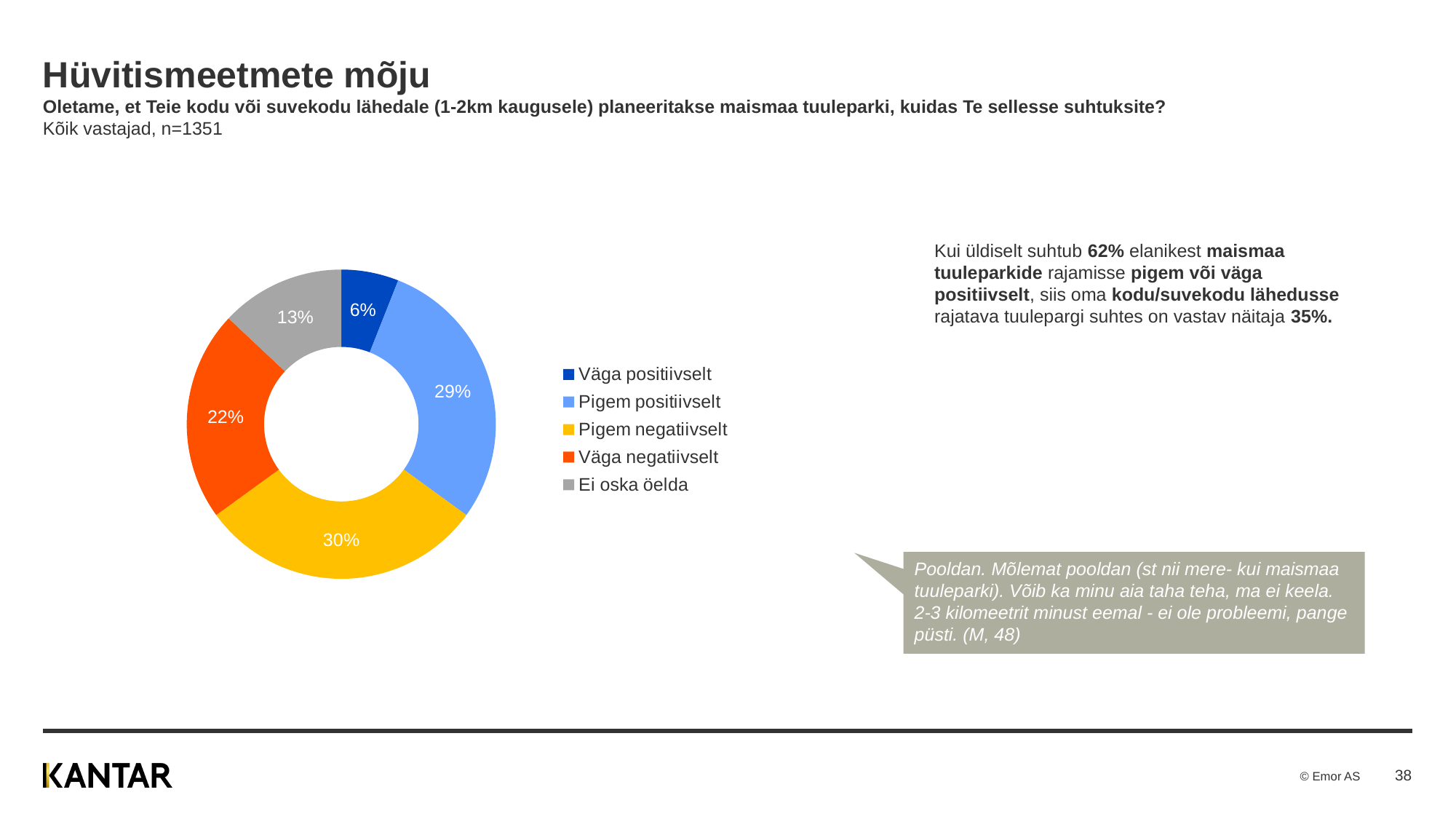
What is the combined share of "Väga positiivselt" and "Pigem positiivselt"? 35% What kind of chart is shown on the slide? Doughnut (pie) chart How many categories does the chart show? 5 What percentage of respondents answered "Pigem negatiivselt"? 30% What percentage of respondents answered "Ei oska öelda"? 13% Which colour represents "Pigem negatiivselt" in the chart? Yellow What is the difference in percentage points between "Pigem positiivselt" and "Väga positiivselt"? 23 Which response category has the smallest share? Väga positiivselt Which response category has the largest share? Pigem negatiivselt What percentage of respondents answered "Väga negatiivselt"? 22% Which is larger: the share for "Väga negatiivselt" or the share for "Ei oska öelda"? Väga negatiivselt What percentage of respondents answered "Väga positiivselt"? 6%